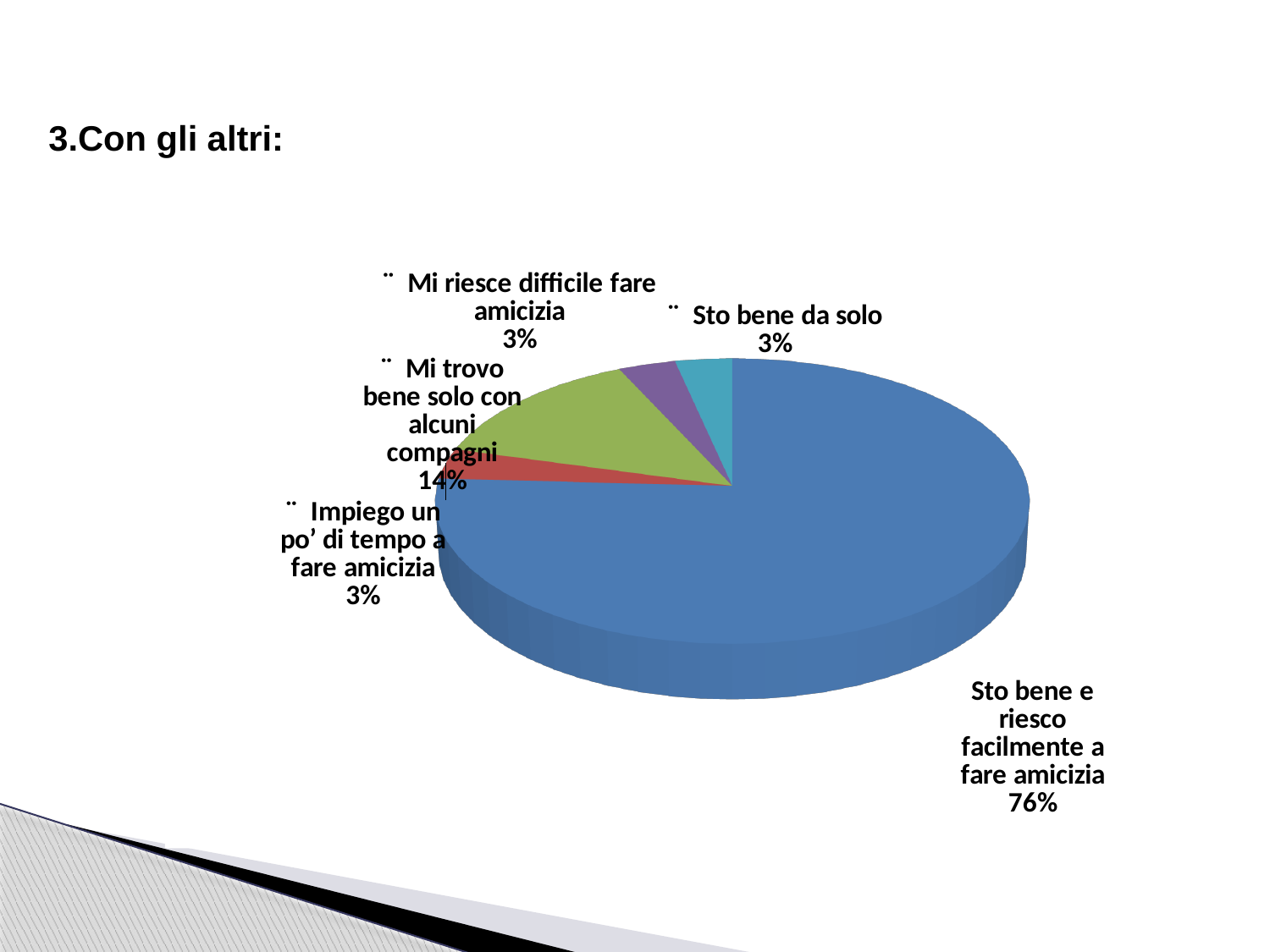
What is the title text shown at the top of the slide? 3.Con gli altri: What percentage of the pie is labelled "Sto bene e riesco facilmente a fare amicizia"? 76% What percentage is shown for "Mi riesce difficile fare amicizia"? 3% Which category has the largest slice of the pie? Sto bene e riesco facilmente a fare amicizia Which is larger: the slice for "Mi trovo bene solo con alcuni compagni" or the slice for "Sto bene da solo"? Mi trovo bene solo con alcuni compagni What percentage is shown for "Sto bene da solo"? 3% What percentage is shown for "Mi trovo bene solo con alcuni compagni"? 14% What kind of chart is shown on the slide? pie chart What percentage is shown for "Impiego un po' di tempo a fare amicizia"? 3% How many slices does the pie chart have? 5 What is the difference in percentage points between "Sto bene e riesco facilmente a fare amicizia" and "Mi trovo bene solo con alcuni compagni"? 62% What colour is the largest slice of the pie? blue